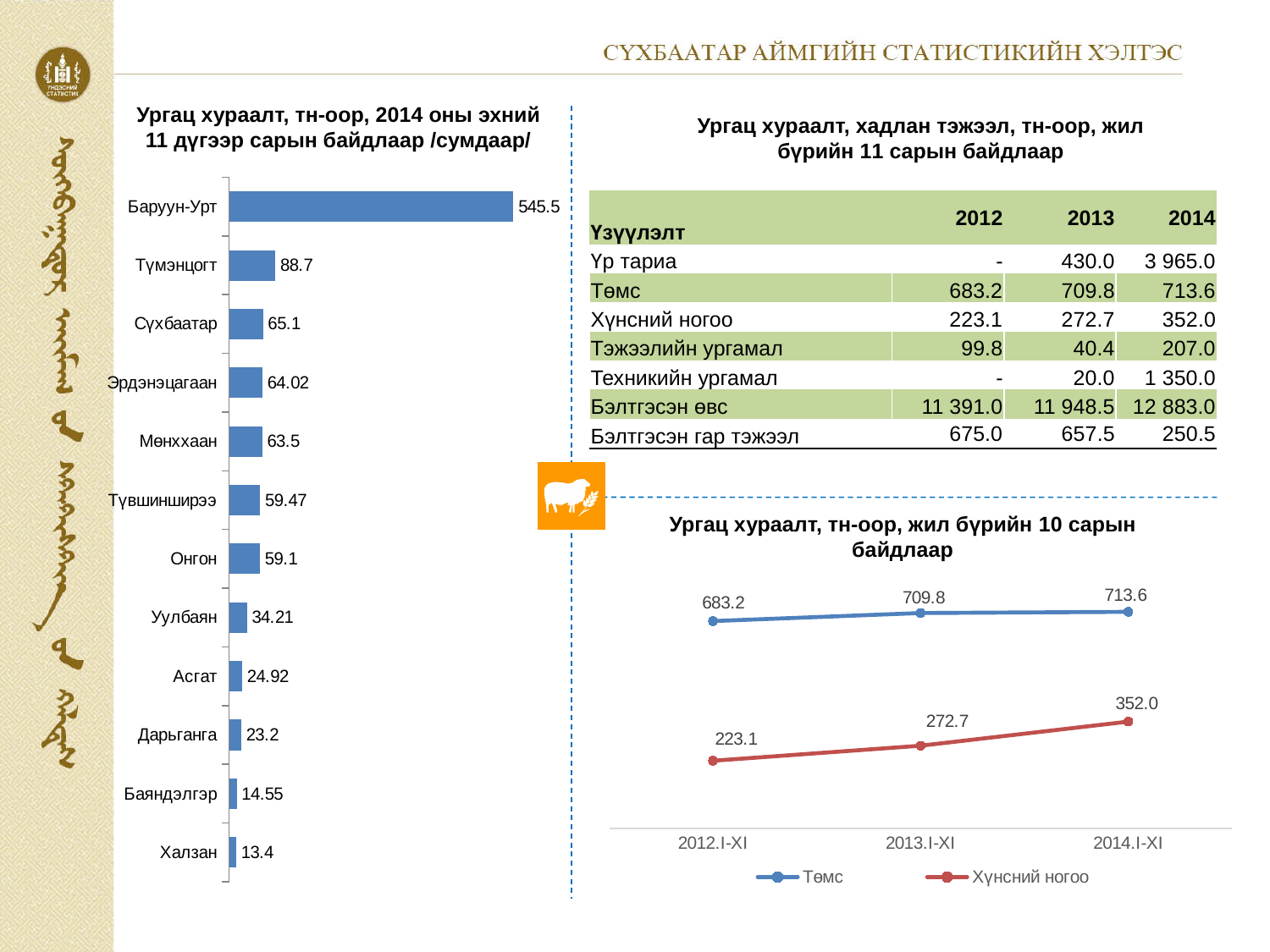
In the bar chart on the left, what is the value for Түвшинширээ? 59.47 In the line chart at the bottom right, what is the difference between the Төмс and Хүнсний ногоо values in 2013.I-XI? 437.1 In the bar chart on the left, which soum has the lowest value? Халзан What type of chart is the chart on the left of the slide? bar chart In the line chart at the bottom right, what is the value for Хүнсний ногоо in 2014.I-XI? 352.0 In the bar chart on the left, which is larger, the value for Уулбаян or the value for Асгат? Уулбаян How many soums are shown in the bar chart on the left? 12 In the line chart at the bottom right, how many series does the legend list? 2 In the bar chart on the left, what is the difference between the values for Түмэнцогт and Сүхбаатар? 23.6 In the bar chart on the left, which soum has the highest value? Баруун-Урт In the bar chart on the left, what is the value for Баруун-Урт? 545.5 In the line chart at the bottom right, does the Төмс series rise or fall from 2012.I-XI to 2014.I-XI? rise